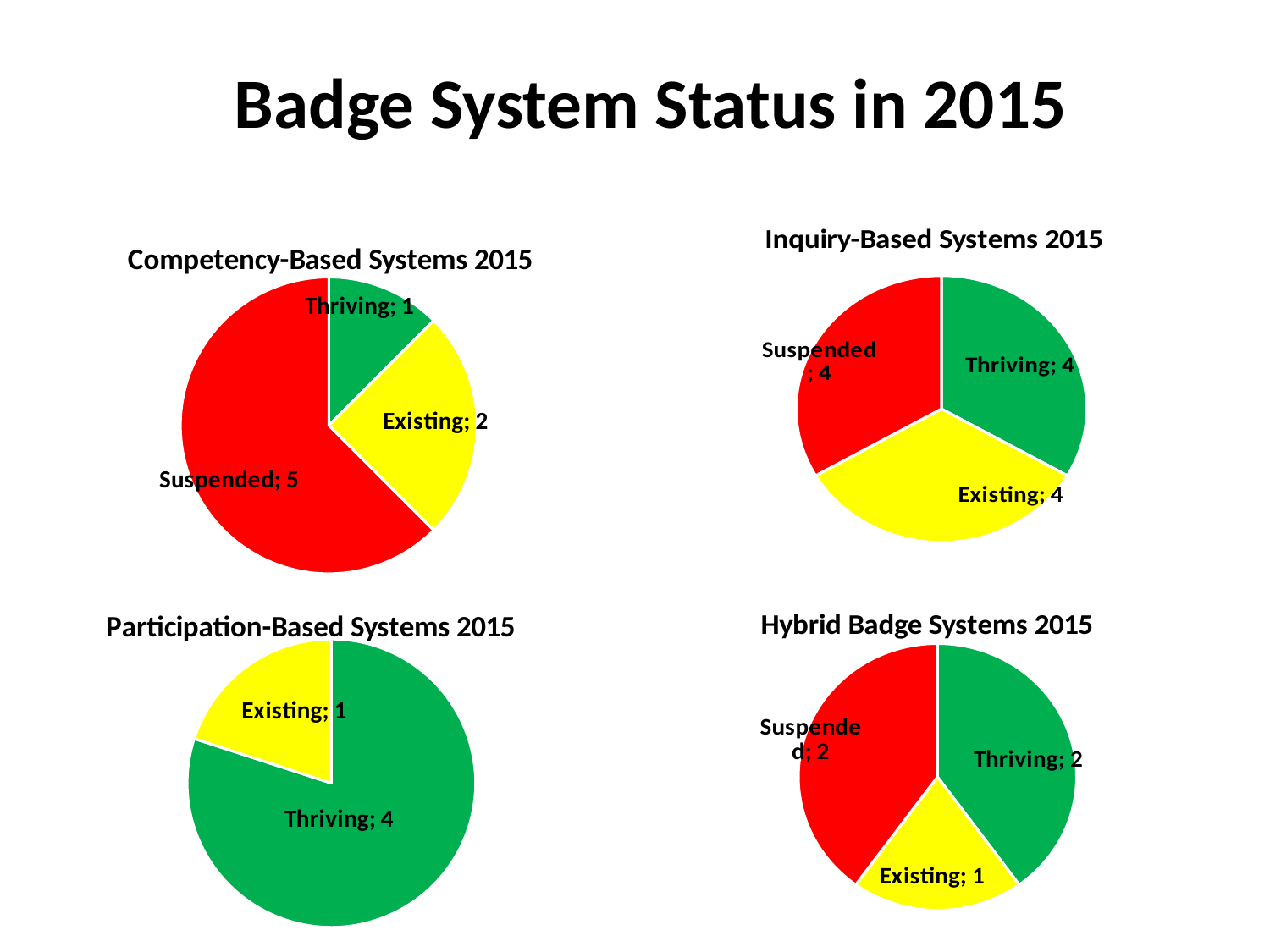
In the Participation-Based Systems 2015 chart, which category has the largest slice? Thriving In the Hybrid Badge Systems 2015 chart, what is the value for Existing? 1 In the Inquiry-Based Systems 2015 chart, what is the total of all slices? 12 In the Competency-Based Systems 2015 chart, what is the value for Suspended? 5 How many slices does the Participation-Based Systems 2015 chart have? 2 In the Competency-Based Systems 2015 chart, what is the difference between Suspended and Existing? 3 What kind of chart is the Inquiry-Based Systems 2015 chart? Pie chart In the Inquiry-Based Systems 2015 chart, what is the value for Existing? 4 In the Hybrid Badge Systems 2015 chart, which is larger, Suspended or Existing? Suspended What colour is the Suspended slice in the Hybrid Badge Systems 2015 chart? Red In the Competency-Based Systems 2015 chart, which category has the smallest slice? Thriving In the Participation-Based Systems 2015 chart, what share of the pie does Thriving represent? 80%